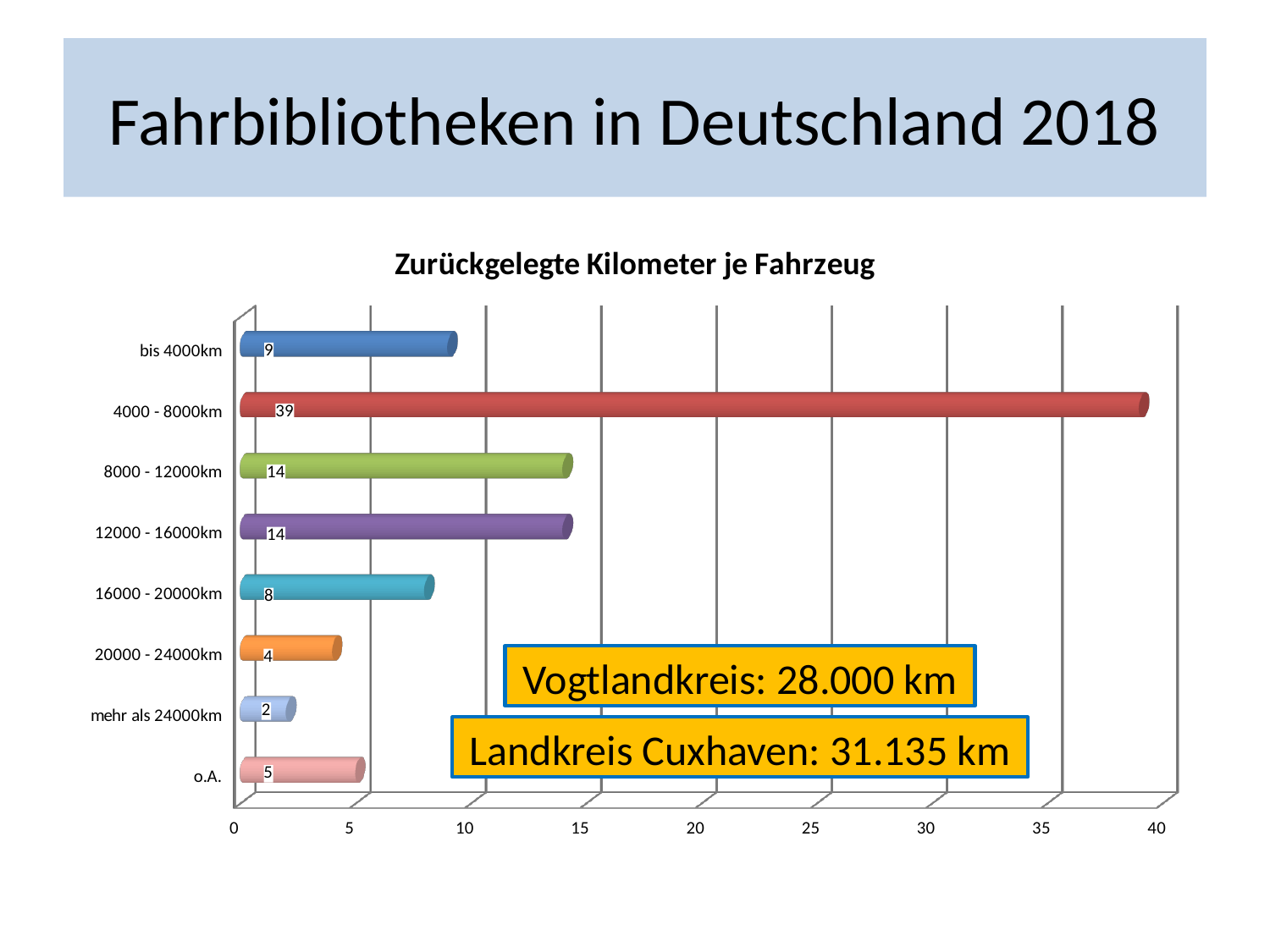
What is the value for the 'o.A.' category? 5 What is the title of the chart? Zurückgelegte Kilometer je Fahrzeug What is the value for the 'bis 4000km' category? 9 Which category has the highest value? 4000 - 8000km What is the difference between the values for '4000 - 8000km' and '8000 - 12000km'? 25 Which category has the lowest value? mehr als 24000km Which is larger, the value for '16000 - 20000km' or the value for '20000 - 24000km'? 16000 - 20000km What is the value for the '4000 - 8000km' category? 39 What kind of chart is shown on the slide? bar chart What is the value for the 'mehr als 24000km' category? 2 How many categories are shown in the chart? 8 Is the value for '12000 - 16000km' greater or less than 10? greater